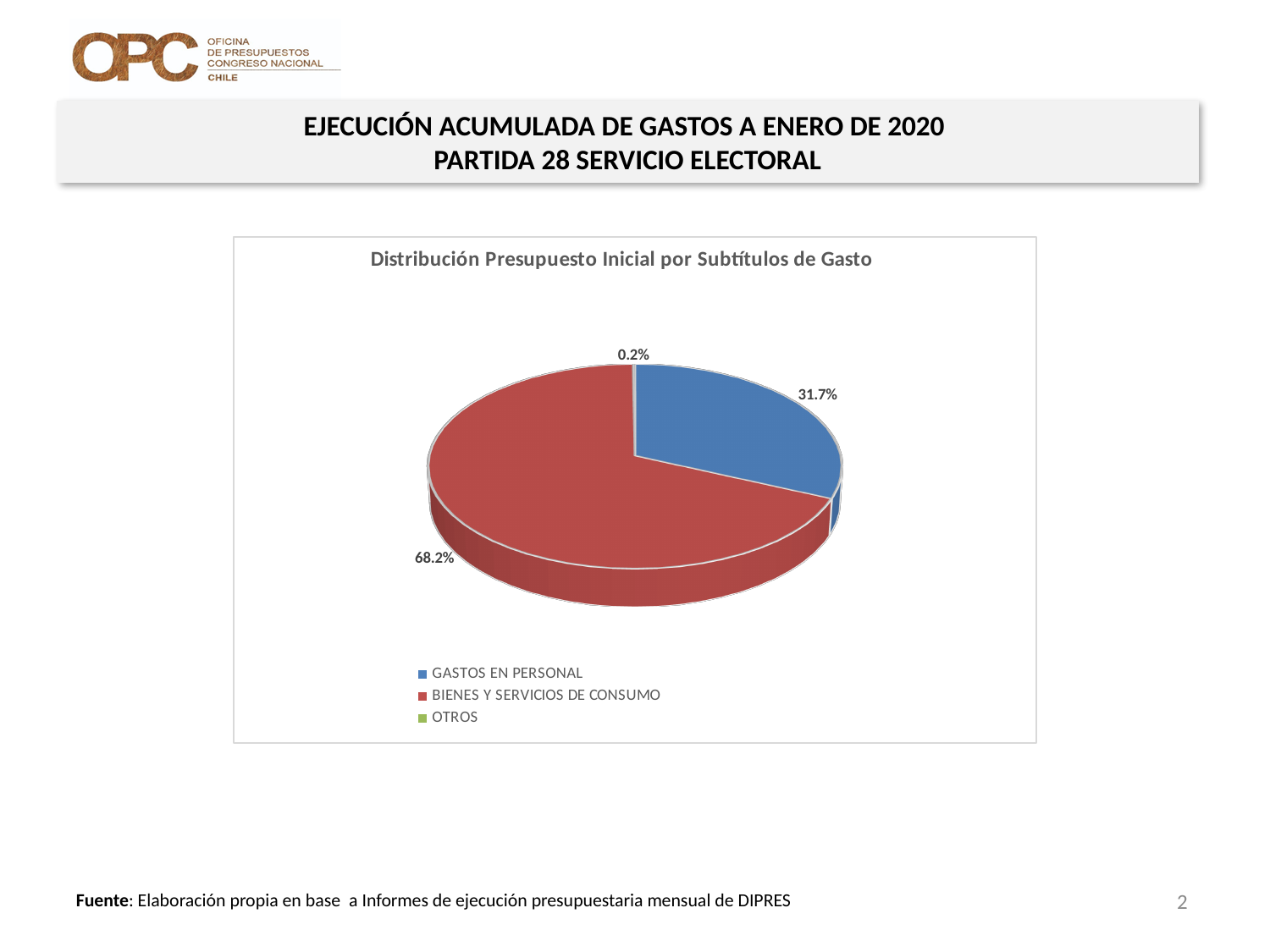
What type of chart is shown on the slide? Pie chart What is the difference in percentage points between the GASTOS EN PERSONAL share and the OTROS share? 31.5 percentage points How many categories does the legend list? 3 What share of the pie does BIENES Y SERVICIOS DE CONSUMO represent? 68.2% What is the difference in percentage points between the BIENES Y SERVICIOS DE CONSUMO share and the GASTOS EN PERSONAL share? 36.5 percentage points What share of the pie does OTROS represent? 0.2% Which category has the smallest share of the pie? OTROS What share of the pie does GASTOS EN PERSONAL represent? 31.7% Which category has the largest share of the pie? BIENES Y SERVICIOS DE CONSUMO Which is larger, the share for GASTOS EN PERSONAL or the share for BIENES Y SERVICIOS DE CONSUMO? BIENES Y SERVICIOS DE CONSUMO What is the title of the chart? Distribución Presupuesto Inicial por Subtítulos de Gasto What colour is the slice for GASTOS EN PERSONAL? Blue